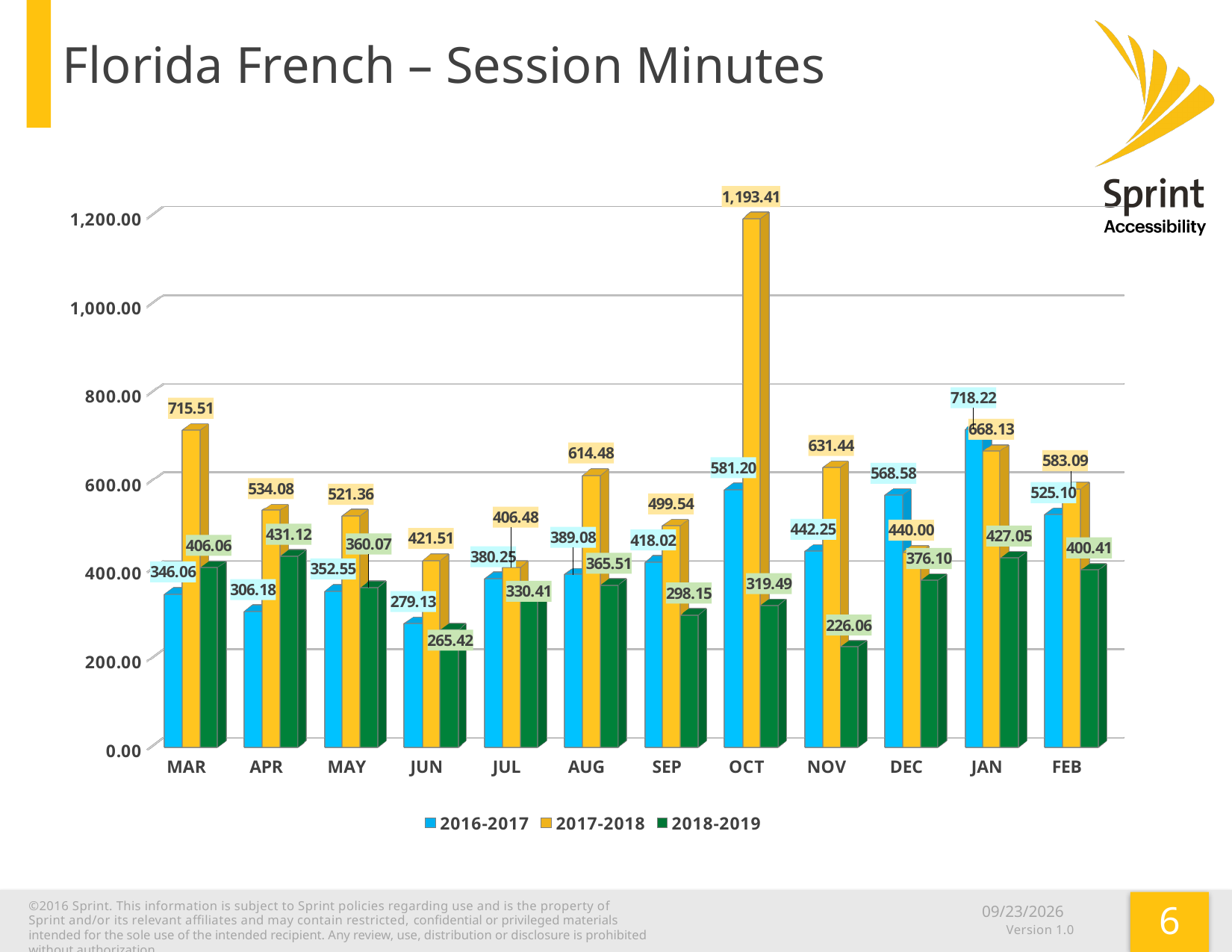
Which month has the lowest 2016-2017 value? JUN For DEC, which series has the larger value, 2016-2017 or 2017-2018? 2016-2017 What is the difference between the 2017-2018 and 2016-2017 values for OCT? 612.21 What is the 2018-2019 value for JUN? 265.42 How many months are shown on the x axis? 12 Which month has the lowest 2018-2019 value? NOV Which month has the highest 2016-2017 value? JAN How many series does the legend list? 3 What is the title of the slide? Florida French – Session Minutes What is the difference between the 2016-2017 and 2017-2018 values for JAN? 50.09 What is the 2017-2018 value for OCT? 1,193.41 What kind of chart is shown on the slide? Bar chart